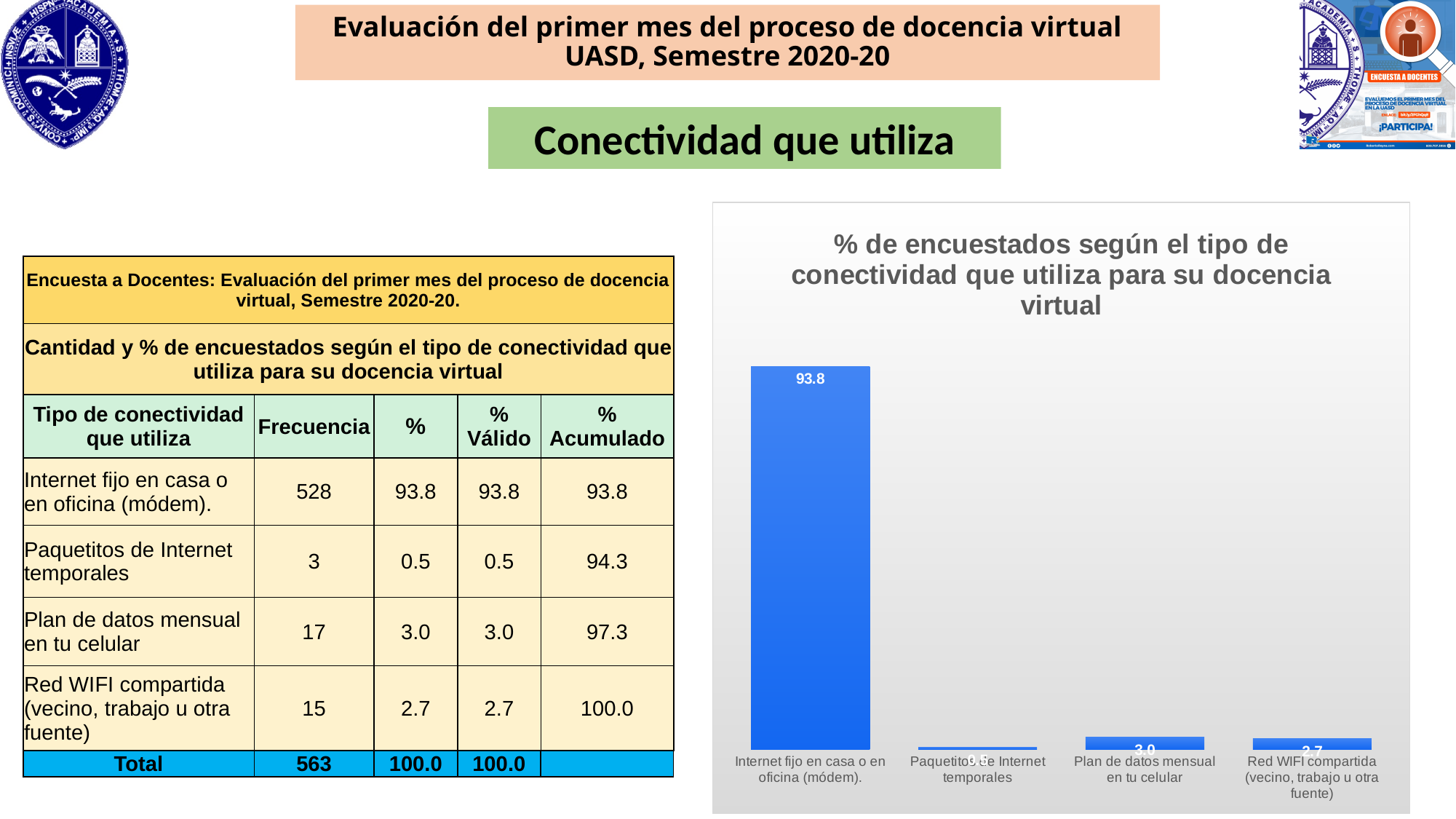
What is the value for 'Internet fijo en casa o en oficina (módem).' in the chart? 93.8 Which category has the lowest value in the chart? Paquetitos de Internet temporales How many categories are plotted in the chart? 4 What is the value for 'Plan de datos mensual en tu celular' in the chart? 3.0 Which is larger: the value for 'Plan de datos mensual en tu celular' or the value for 'Paquetitos de Internet temporales'? Plan de datos mensual en tu celular What is the value for 'Paquetitos de Internet temporales' in the chart? 0.5 What is the value for 'Red WIFI compartida (vecino, trabajo u otra fuente)' in the chart? 2.7 Which category has the highest value in the chart? Internet fijo en casa o en oficina (módem). What is the title of the chart? % de encuestados según el tipo de conectividad que utiliza para su docencia virtual What is the difference between the values for 'Internet fijo en casa o en oficina (módem).' and 'Plan de datos mensual en tu celular'? 90.8 What colour are the bars in the chart? blue What type of chart is shown on the slide? bar chart